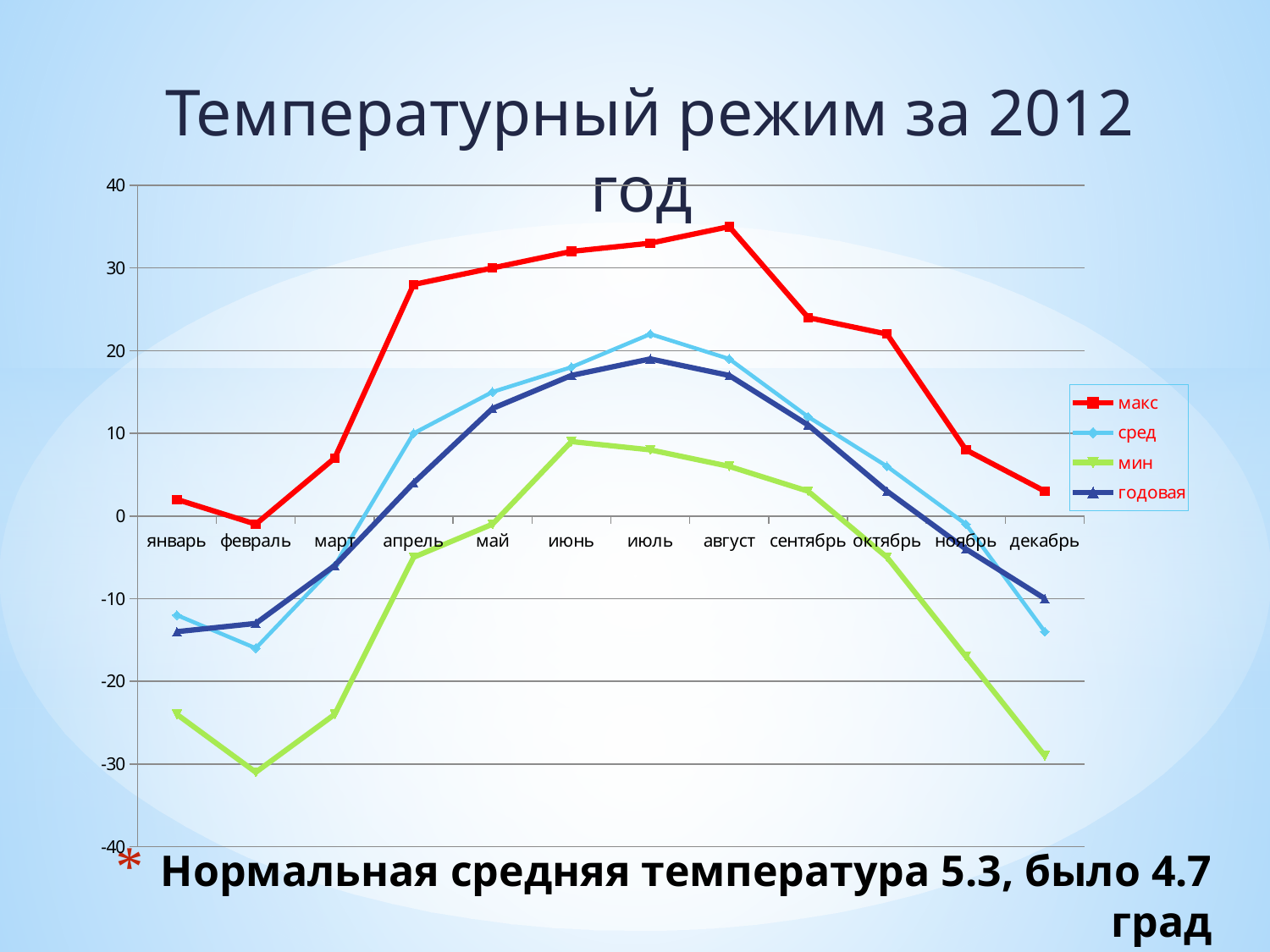
Is the value of мин for январь greater or less than -20? less How many series does the legend list? 4 Is the value of сред for декабрь greater or less than -10? less Is the value of макс for август greater or less than 30? greater Does the макс series rise or fall from март to август? rise What kind of chart is shown on the slide? line chart Which is higher: макс in апрель or макс in сентябрь? апрель In июль, which is higher: сред or годовая? сред How many months are plotted along the x axis? 12 In which month does the макс series reach its highest value? август In which month does the мин series reach its lowest value? февраль What is the title of the chart? Температурный режим за 2012 год